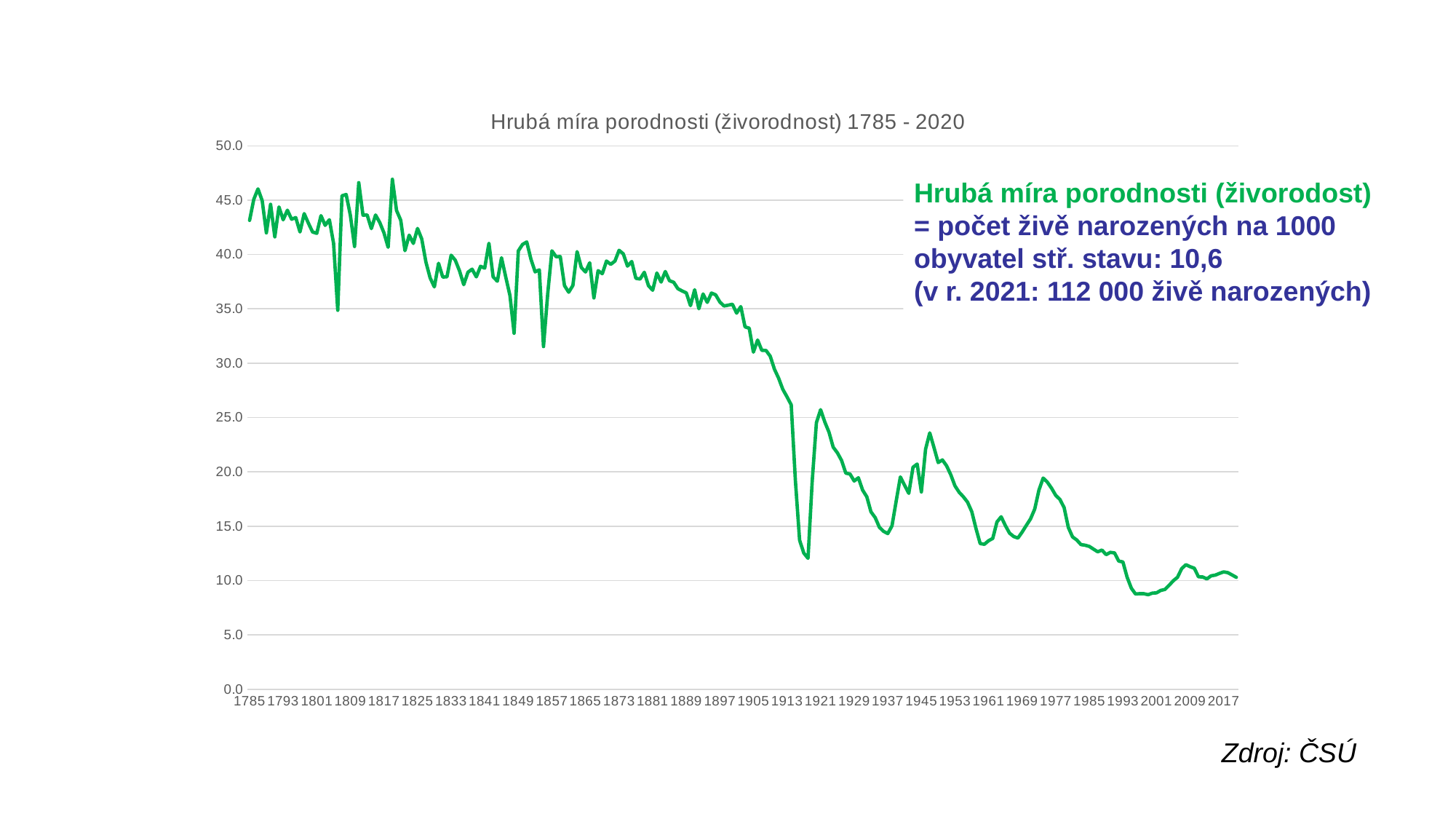
Is the value for 1945 greater or less than 30? less Is the value for 1977 greater or less than 15? greater Is the value for 1993 greater or less than 15? less Overall, do the values rise or fall from 1785 to 2020? fall What is the title of the chart? Hrubá míra porodnosti (živorodnost) 1785 - 2020 What is the highest value shown on the vertical axis? 50.0 What kind of chart is shown on the slide? line chart Which is larger, the value for 1785 or the value for 2017? 1785